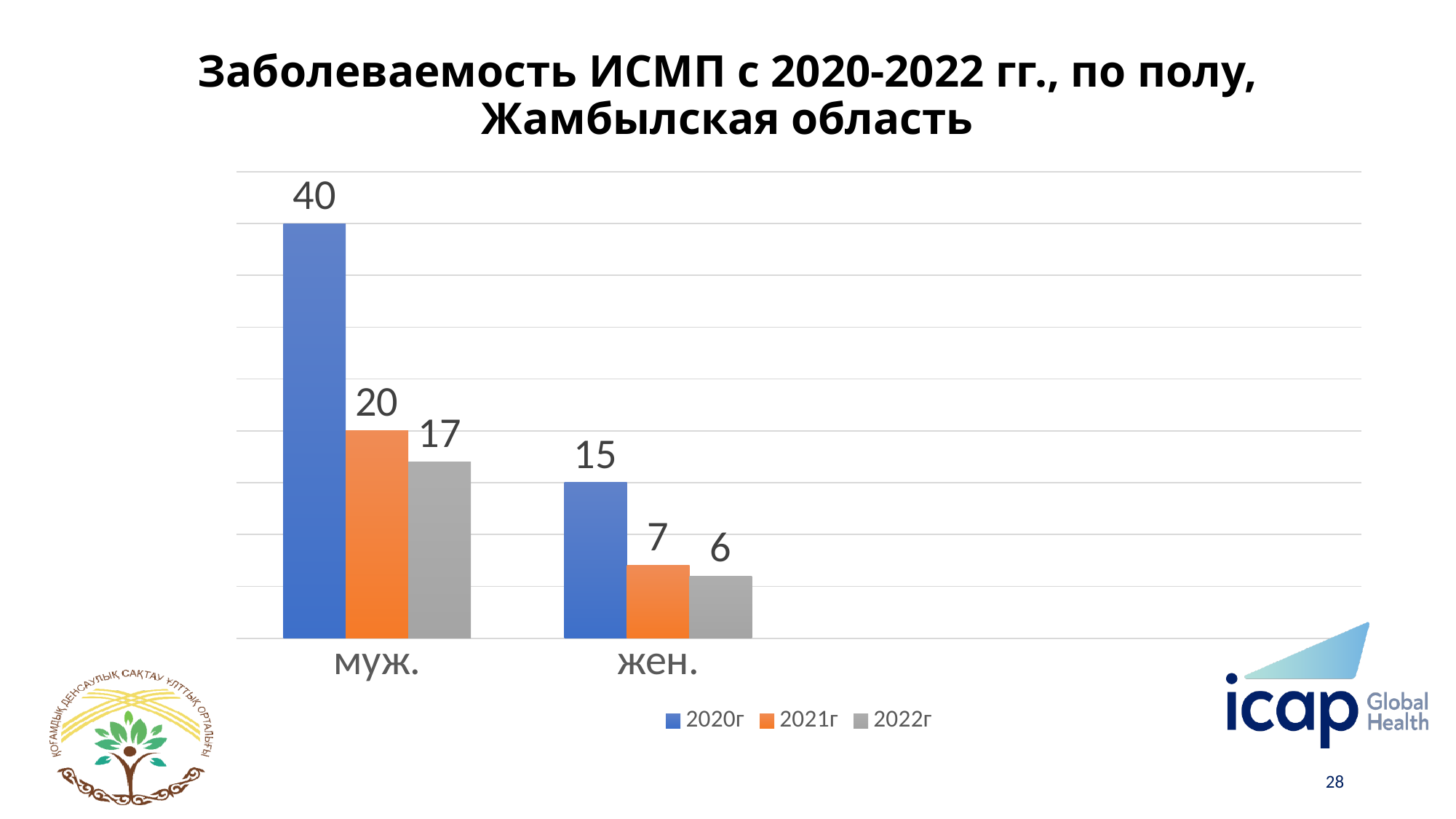
What is the difference between the 2021г and 2022г values for муж.? 3 What kind of chart is shown on the slide? Bar chart Which category has the highest value in the 2020г series? муж. Which is larger: the 2021г value for муж. or the 2020г value for жен.? 2021г value for муж. How many series does the legend list? 3 What is the value for жен. in the 2022г series? 6 What is the value for муж. in the 2020г series? 40 Which category has the lowest value in the 2022г series? жен. What is the value for муж. in the 2022г series? 17 How many categories are shown on the x axis? 2 What is the difference between the 2020г values for муж. and жен.? 25 What is the value for жен. in the 2021г series? 7